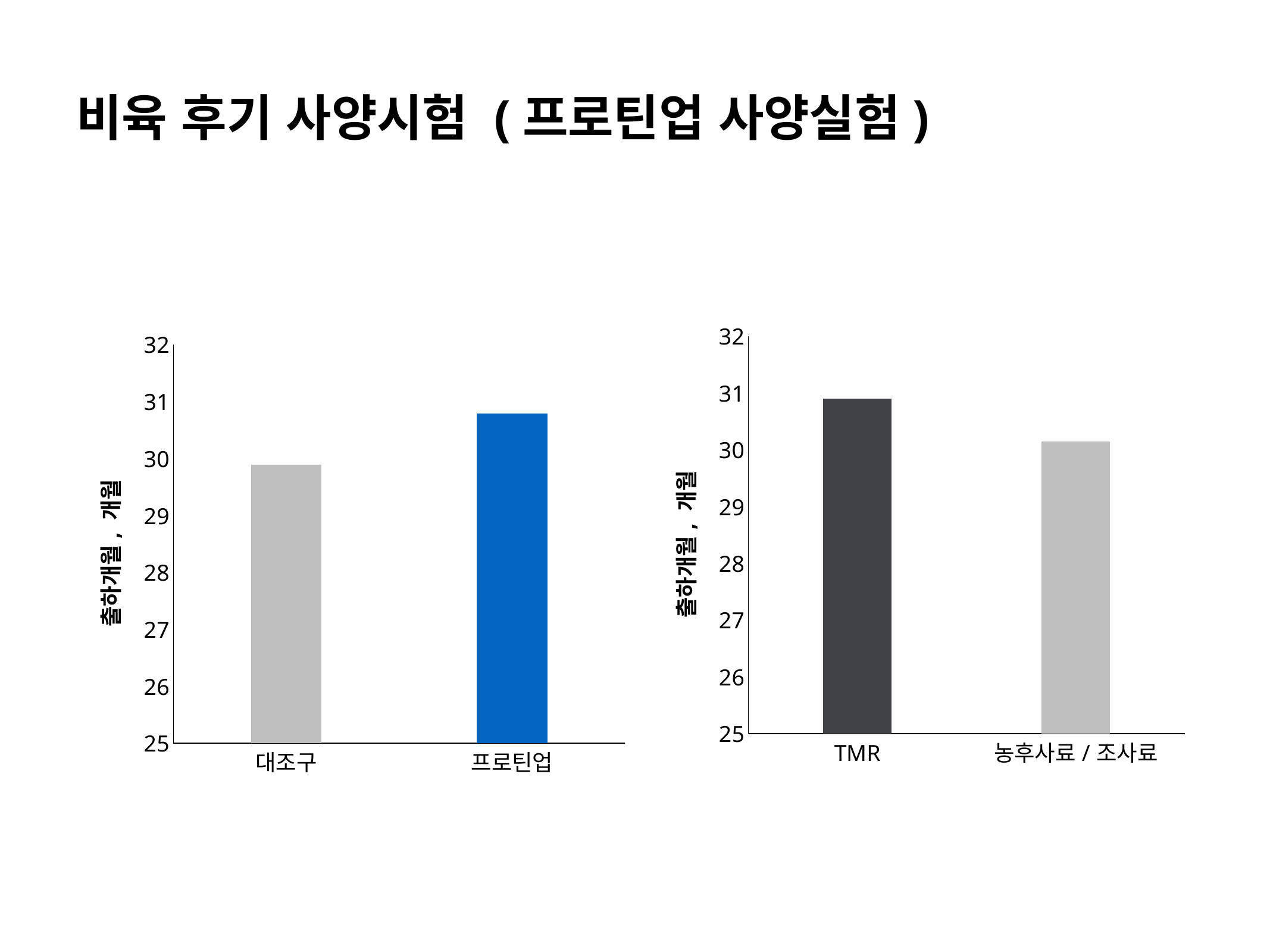
How many categories does the right chart show? 2 What is the y-axis label of the right chart? 출하개월 , 개월 In the left chart, which category has the lowest value? 대조구 In the left chart, which category has the higher value, 대조구 or 프로틴업? 프로틴업 In the left chart, is the value for 프로틴업 greater or less than 30? greater How many categories does the left chart show? 2 In the right chart, is the value for 농후사료 / 조사료 greater or less than 31? less In the right chart, which category has the highest value? TMR In the left chart, is the value for 대조구 greater or less than 29? greater What kind of chart is the left chart on the slide? bar chart In the right chart, which category has the higher value, TMR or 농후사료 / 조사료? TMR